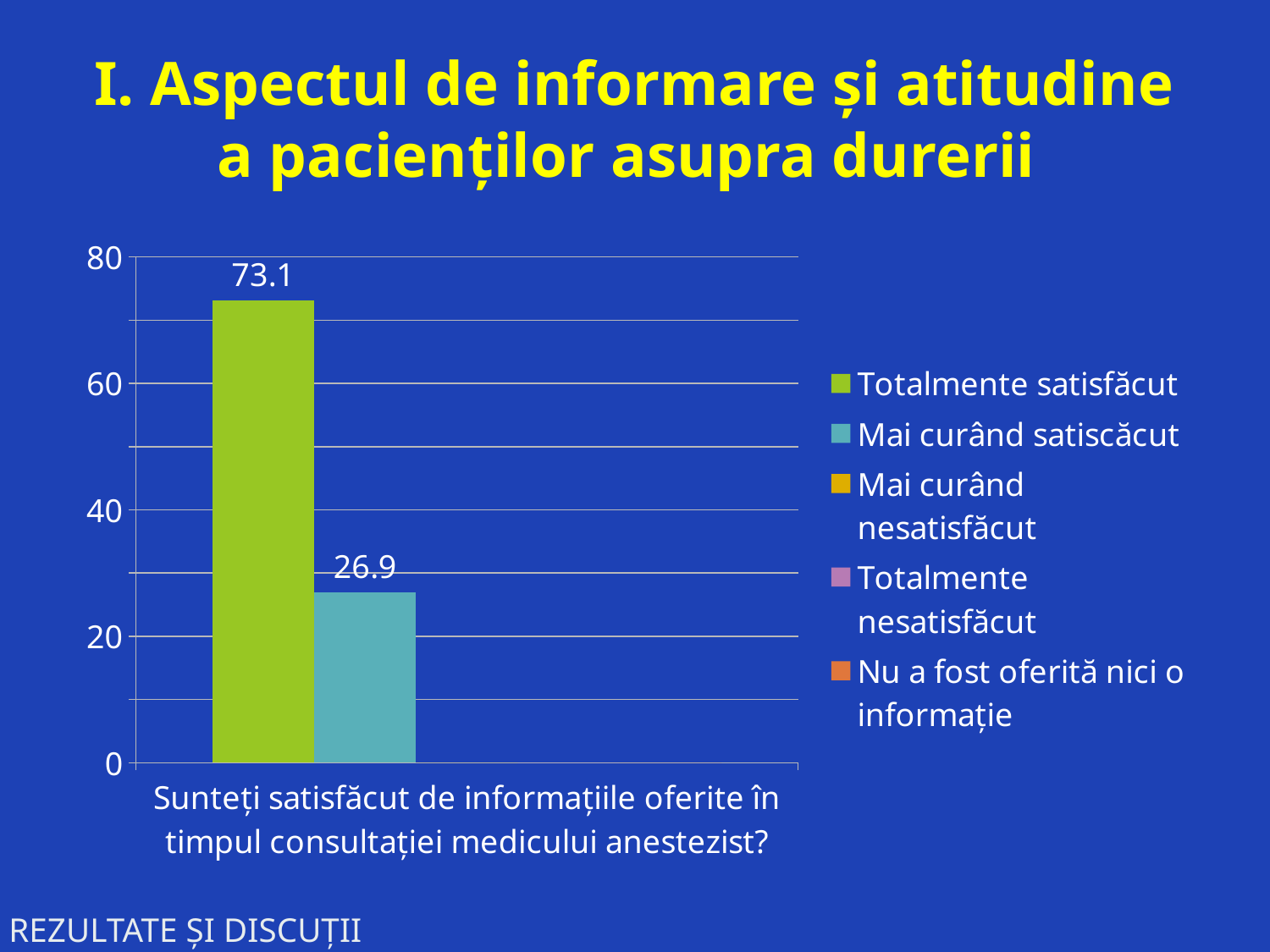
Which is larger, the value for "Totalmente satisfăcut" or for "Mai curând satiscăcut"? Totalmente satisfăcut What kind of chart is shown on the slide? Bar chart What colour is the bar for "Totalmente satisfăcut"? Green How many bars are plotted on the chart? 2 What is the value for "Mai curând satiscăcut"? 26.9 What is the highest value shown on the vertical axis? 80 Which series has the highest plotted value? Totalmente satisfăcut How many series does the legend list? 5 Is the value for "Totalmente satisfăcut" greater or less than 60? greater What is the value for "Totalmente satisfăcut"? 73.1 What is the difference between the values for "Totalmente satisfăcut" and "Mai curând satiscăcut"? 46.2 Is the value for "Mai curând satiscăcut" greater or less than 40? less